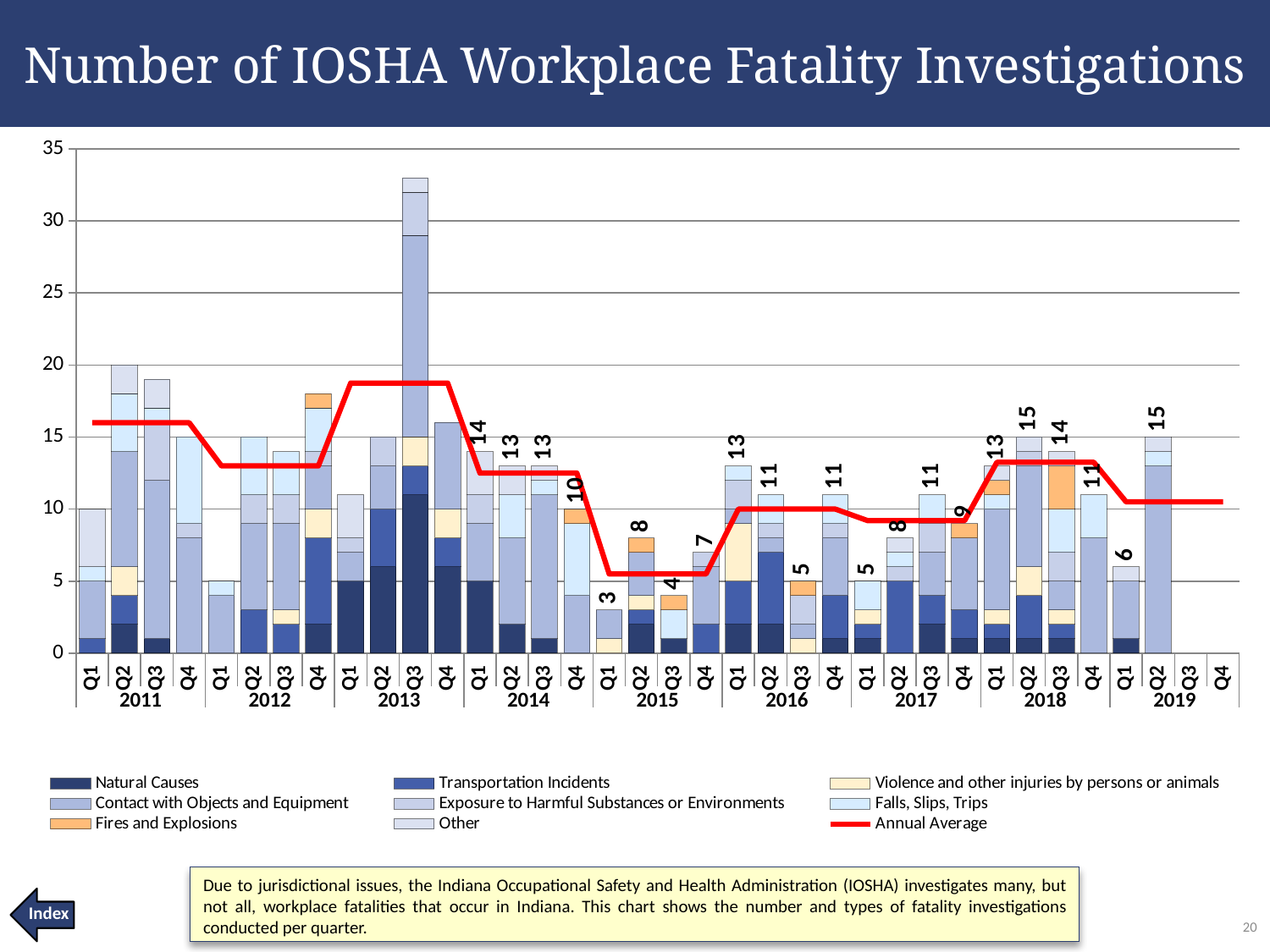
What kind of chart is shown on the slide? combination bar and line chart (stacked bars with a line) Among the quarters with printed totals, which has the lowest number of investigations? Q1 2015 What is the difference between the labeled totals for Q2 2018 and Q1 2019? 9 Which quarter has the tallest bar in the chart? Q3 2013 What is the total number of fatality investigations labeled for Q2 2018? 15 What is the total number of fatality investigations labeled for Q1 2015? 3 Is the total for Q3 2011 greater or less than 15? greater What does the red line in the chart represent? Annual Average Is the total for Q3 2013 greater or less than 30? greater How many entries does the legend list? 9 What is the total number of fatality investigations labeled for Q4 2017? 9 Which has a higher labeled total, Q1 2016 or Q1 2017? Q1 2016